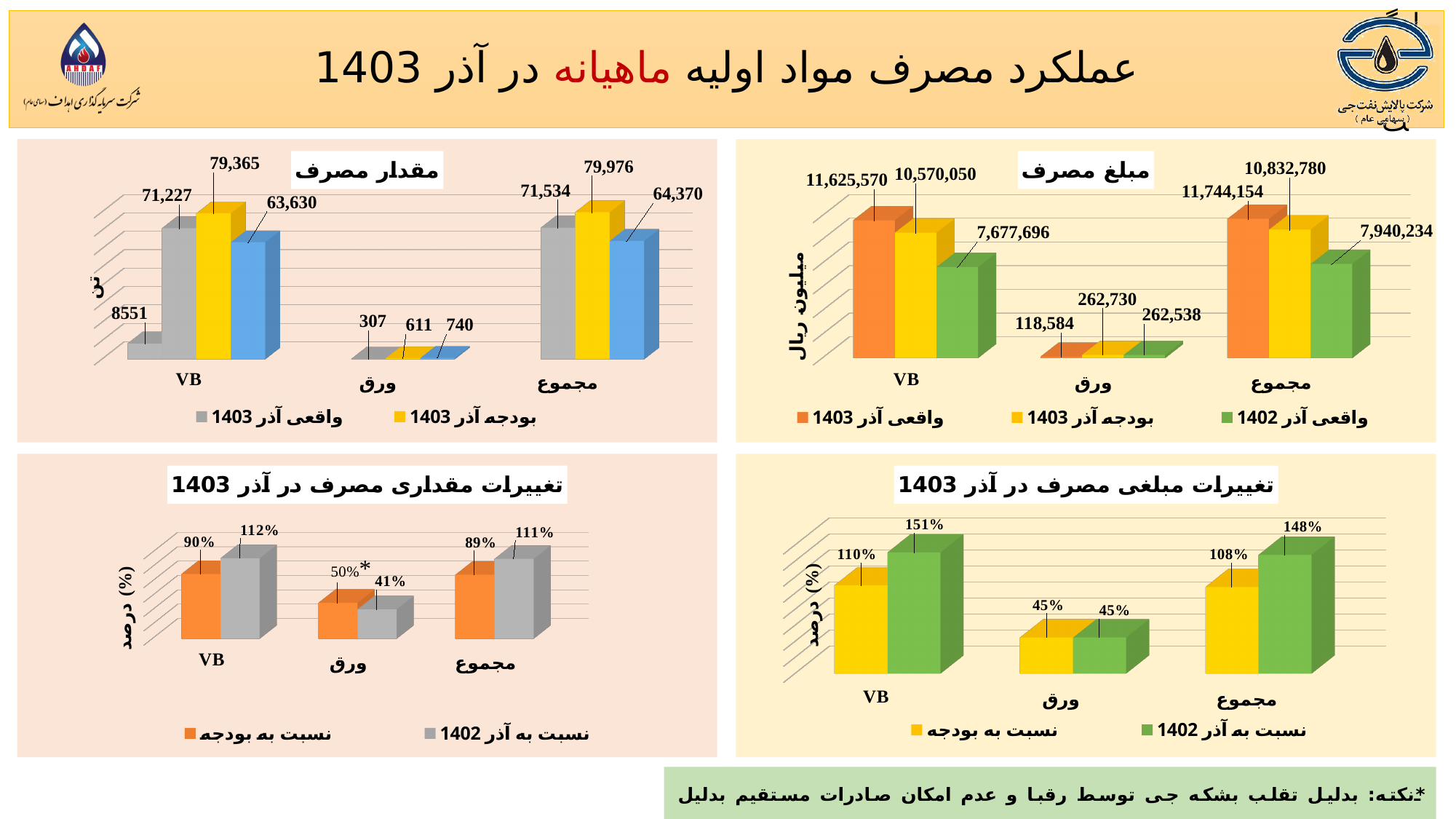
In the 'مبلغ مصرف' chart (top right), what is the difference between 'بودجه آذر 1403' and 'واقعی آذر 1403' for ورق? 144,146 In the 'تغییرات مقداری مصرف در آذر 1403' chart (bottom left), what is the value of 'نسبت به آذر 1402' for VB? 112% In the 'مقدار مصرف' chart (top left), how many categories are shown on the x axis? 3 In the 'تغییرات مقداری مصرف در آذر 1403' chart (bottom left), which is larger for ورق: 'نسبت به بودجه' or 'نسبت به آذر 1402'? نسبت به بودجه In the 'تغییرات مبلغی مصرف در آذر 1403' chart (bottom right), which category has the highest 'نسبت به آذر 1402' value? VB In the 'مبلغ مصرف' chart (top right), what is the value of 'واقعی آذر 1402' for مجموع? 7,940,234 What kind of chart is the 'تغییرات مبلغی مصرف در آذر 1403' chart (bottom right)? Bar chart In the 'مقدار مصرف' chart (top left), what is the value of 'بودجه آذر 1403' for مجموع? 79,976 In the 'تغییرات مبلغی مصرف در آذر 1403' chart (bottom right), what is the value of 'نسبت به آذر 1402' for مجموع? 148% In the 'مبلغ مصرف' chart (top right), what is the value of 'واقعی آذر 1403' for VB? 11,625,570 In the 'مقدار مصرف' chart (top left), which category has the lowest values? ورق In the 'مبلغ مصرف' chart (top right), how many series does the legend list? 3